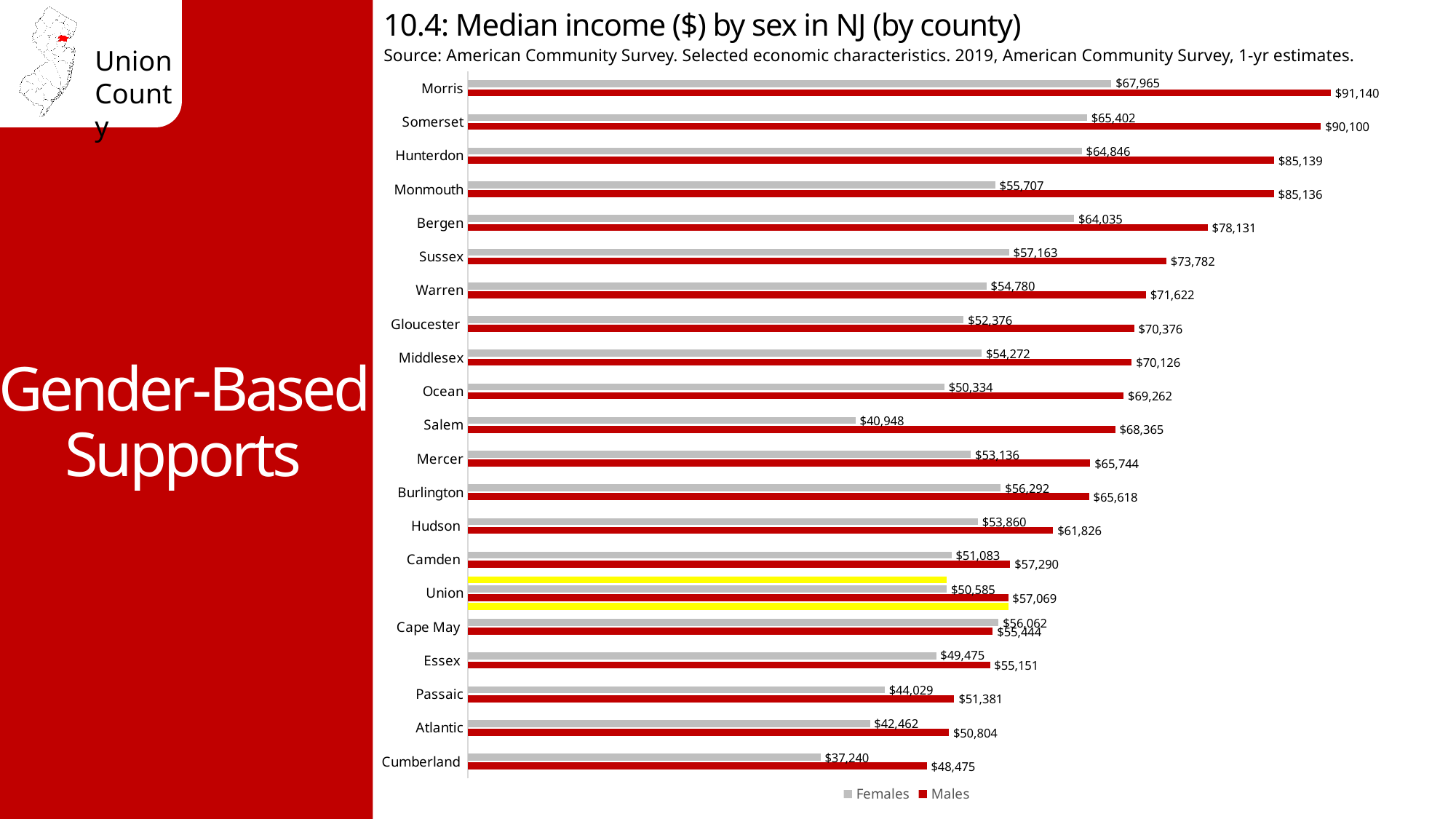
Which county has the lowest median income for females? Cumberland What is the difference between the male and female median incomes in Morris County? $23,175 What is the median income for females in Morris County? $67,965 What is the difference between the male and female median incomes in Union County? $6,484 What is the median income for females in Salem County? $40,948 In Cape May County, which is larger: the female median income or the male median income? Female median income Which county has the highest median income for males? Morris What type of chart is used to show median income by sex? Bar chart Which colour represents the Males series in the chart? Red How many counties are shown in the chart? 21 How many series does the legend list? 2 What is the median income for males in Union County? $57,069